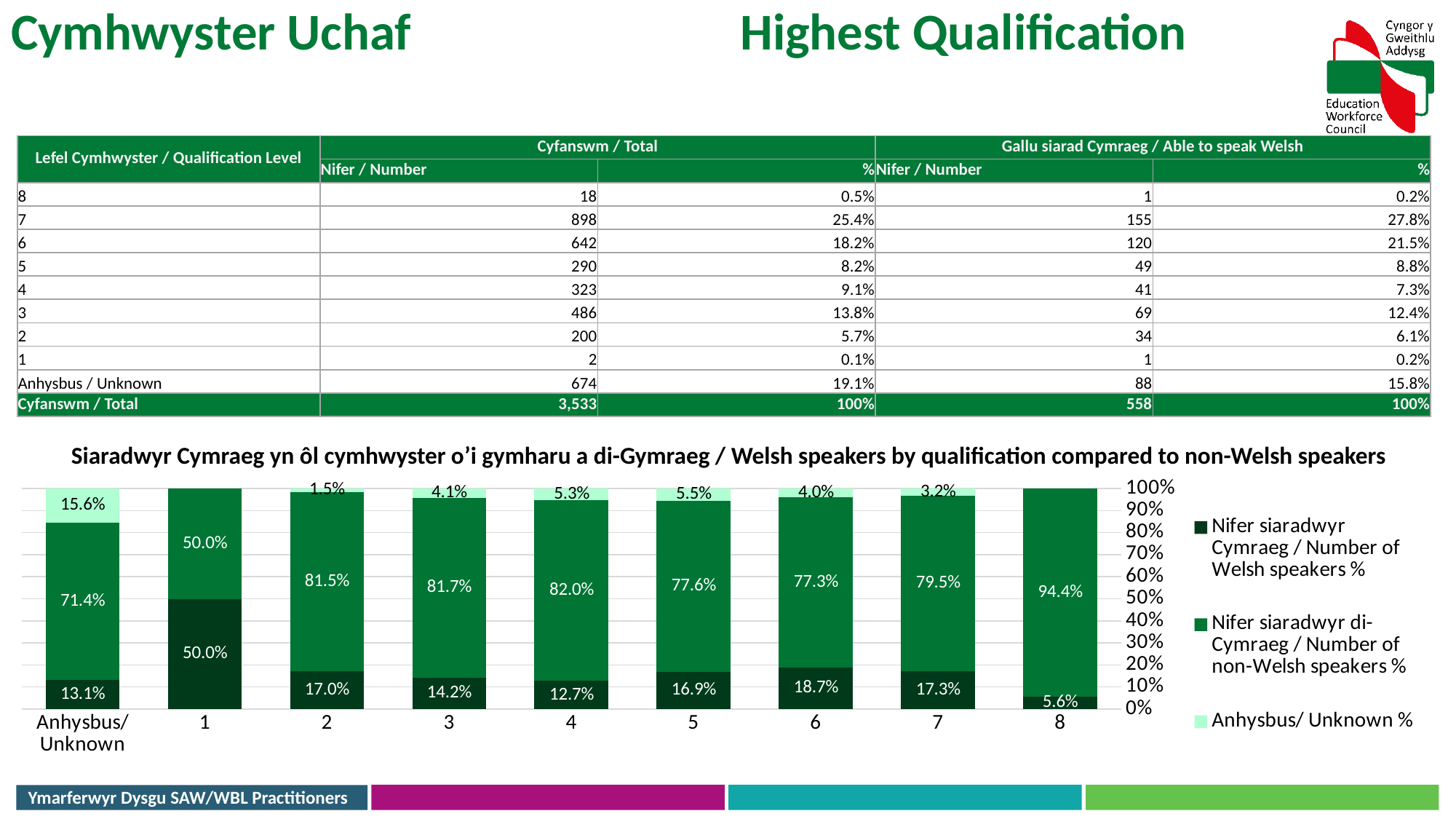
How many series does the chart's legend list? 3 In the chart, what is the Number of non-Welsh speakers % for qualification level 8? 94.4% In the chart, what is the Number of Welsh speakers % for qualification level 6? 18.7% In the chart, what is the Anhysbus/Unknown % for qualification level 5? 5.5% In the chart, what is the difference in Number of Welsh speakers % between qualification level 6 and qualification level 4? 6.0 percentage points What type of chart is shown below the table on the slide? Stacked bar chart In the chart, which qualification level has the highest Number of Welsh speakers %? 1 In the chart, what is the Anhysbus/Unknown % for the Anhysbus/Unknown category? 15.6% How many categories are shown on the x axis of the chart? 9 In the chart, which qualification level has the lowest Number of Welsh speakers %? 8 In the chart, is the Number of Welsh speakers % larger for qualification level 2 or qualification level 4? Qualification level 2 In the chart, which category has the lowest Number of non-Welsh speakers %? 1